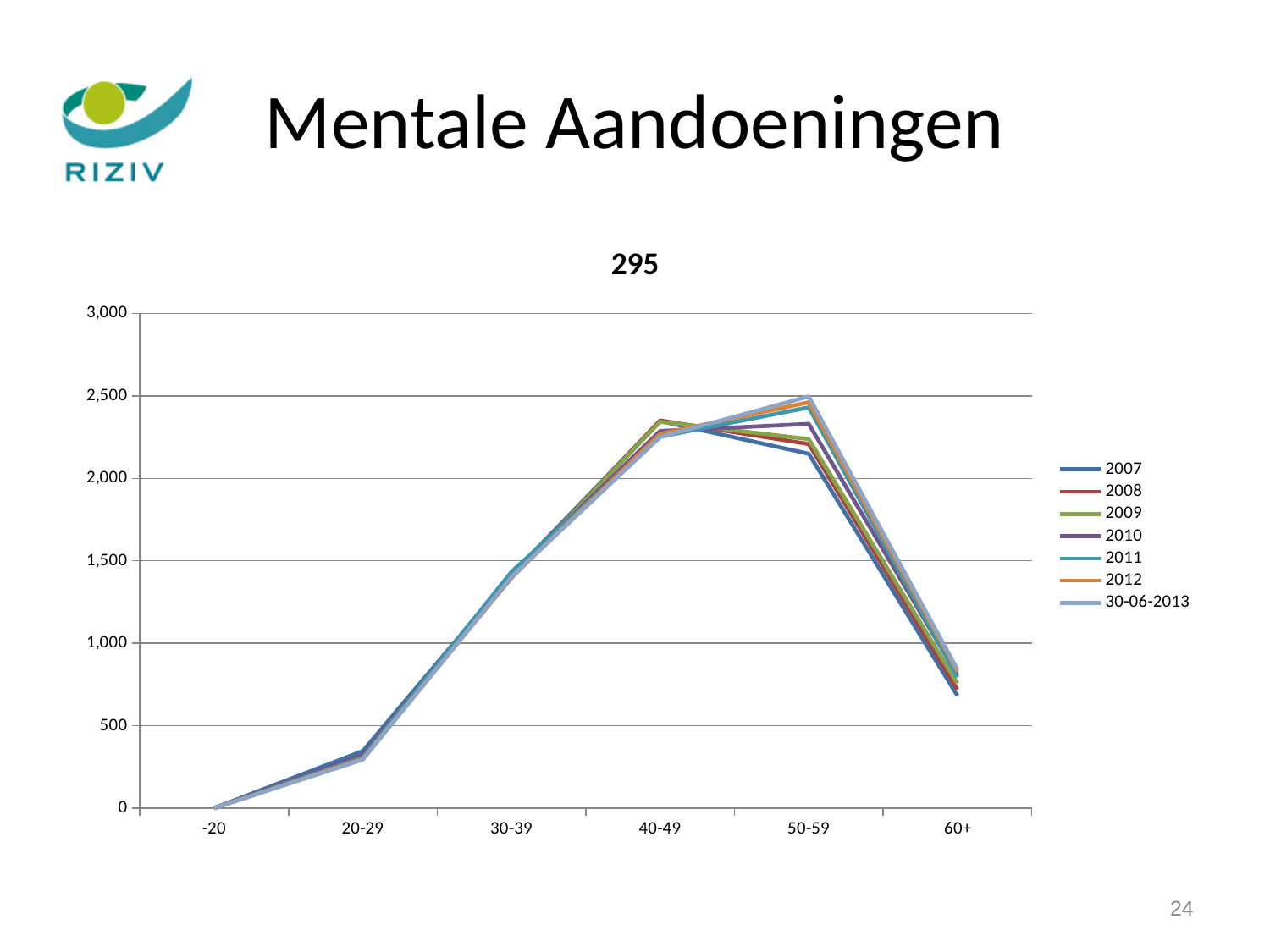
Is the value for 2007 at 60+ greater or less than 1,000? less At 50-59, which series has the larger value: 2007 or 30-06-2013? 30-06-2013 What kind of chart is shown on the slide? line chart How many age categories are shown on the x axis? 6 Is the value for 2007 at 30-39 greater or less than 1,000? greater What is the last entry in the legend? 30-06-2013 How many series does the legend list? 7 Which age category has the highest value for the 30-06-2013 series? 50-59 Is the value for 30-06-2013 at 50-59 greater or less than 2,000? greater Which age category has the lowest value for the 2007 series? -20 What is the title of the chart? 295